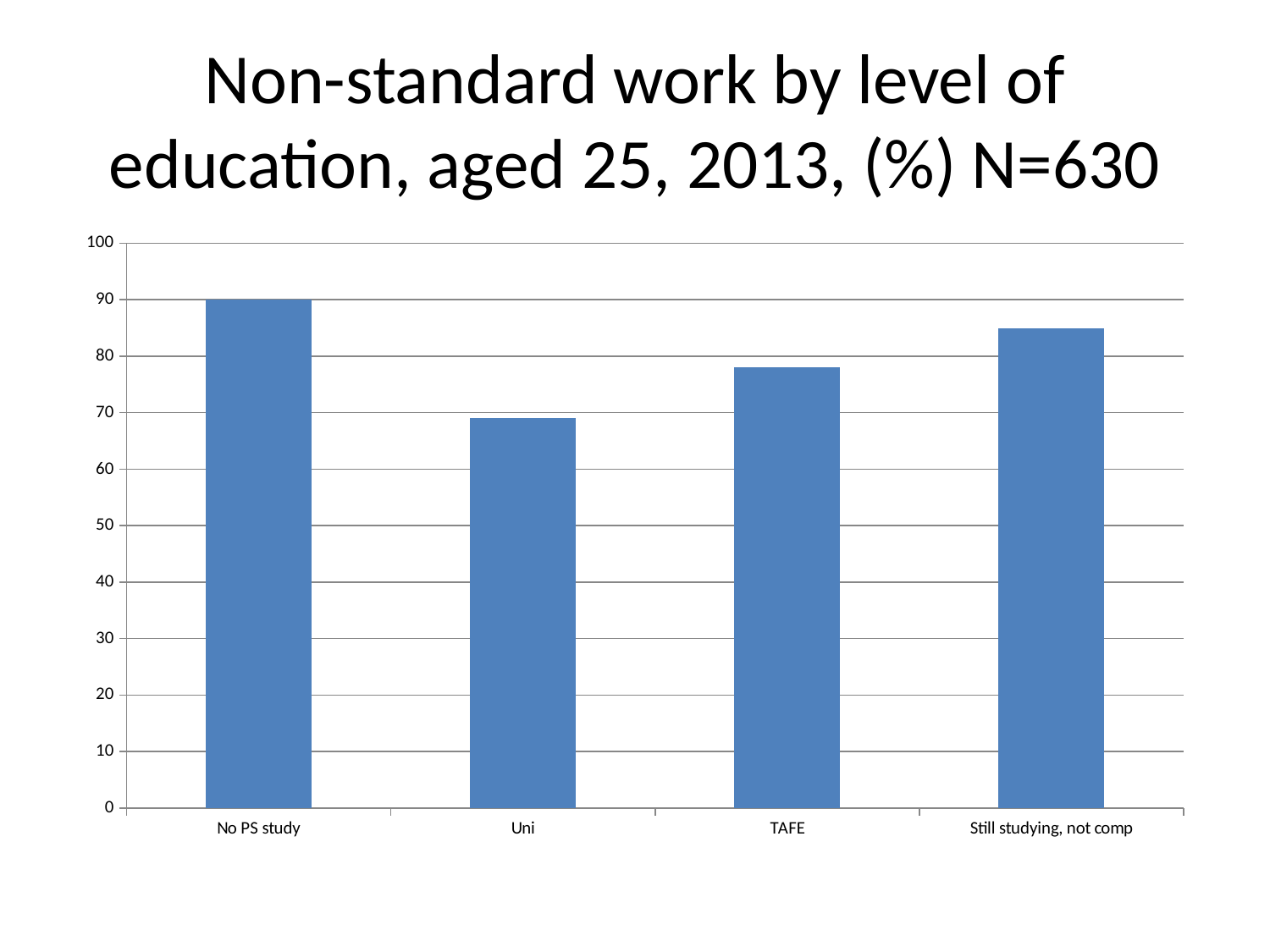
Is the value for TAFE greater or less than 80? less What type of chart is shown on the slide? bar chart Is the value for TAFE greater or less than 70? greater Which is larger, the value for Uni or the value for TAFE? TAFE Is the value for Uni greater or less than 70? less How many education categories are shown on the x axis? 4 What is the value for No PS study? 90 What sample size (N) is stated in the chart title? N=630 Which education category has the highest percentage of non-standard work? No PS study Which education category has the lowest percentage of non-standard work? Uni Which is larger, the value for TAFE or the value for Still studying, not comp? Still studying, not comp